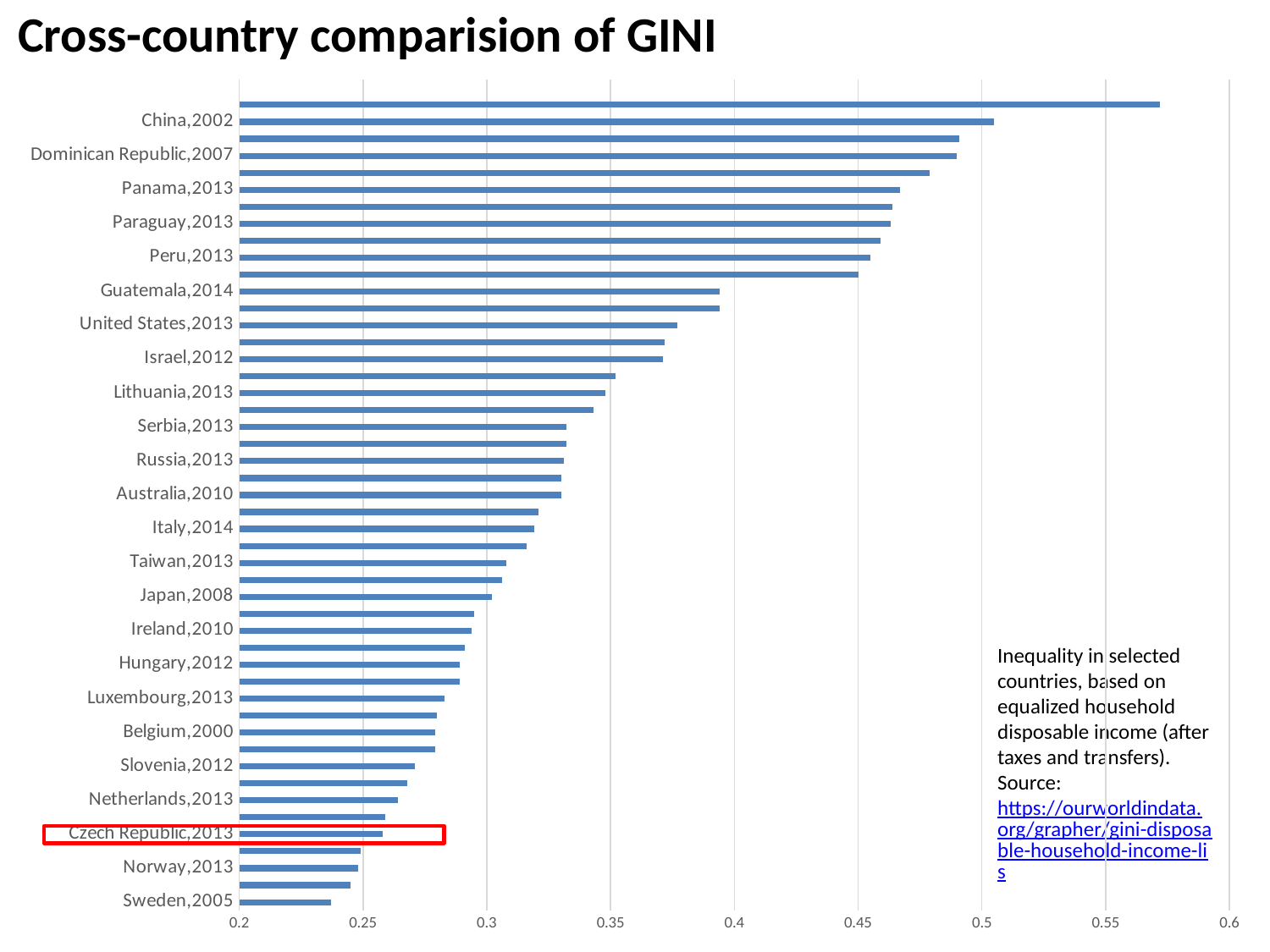
Is the value for United States,2013 greater or less than 0.35? greater Do the bar values increase or decrease going from the top of the chart to the bottom? decrease Which category is highlighted with a red box on the chart? Czech Republic,2013 Is the value for Lithuania,2013 greater or less than 0.4? less Which has the larger value, Guatemala,2014 or Israel,2012? Guatemala,2014 Is the value for Peru,2013 greater or less than 0.4? greater Which has the larger value, China,2002 or Sweden,2005? China,2002 Which labelled category has the lowest value? Sweden,2005 What kind of chart is shown on the slide? bar chart